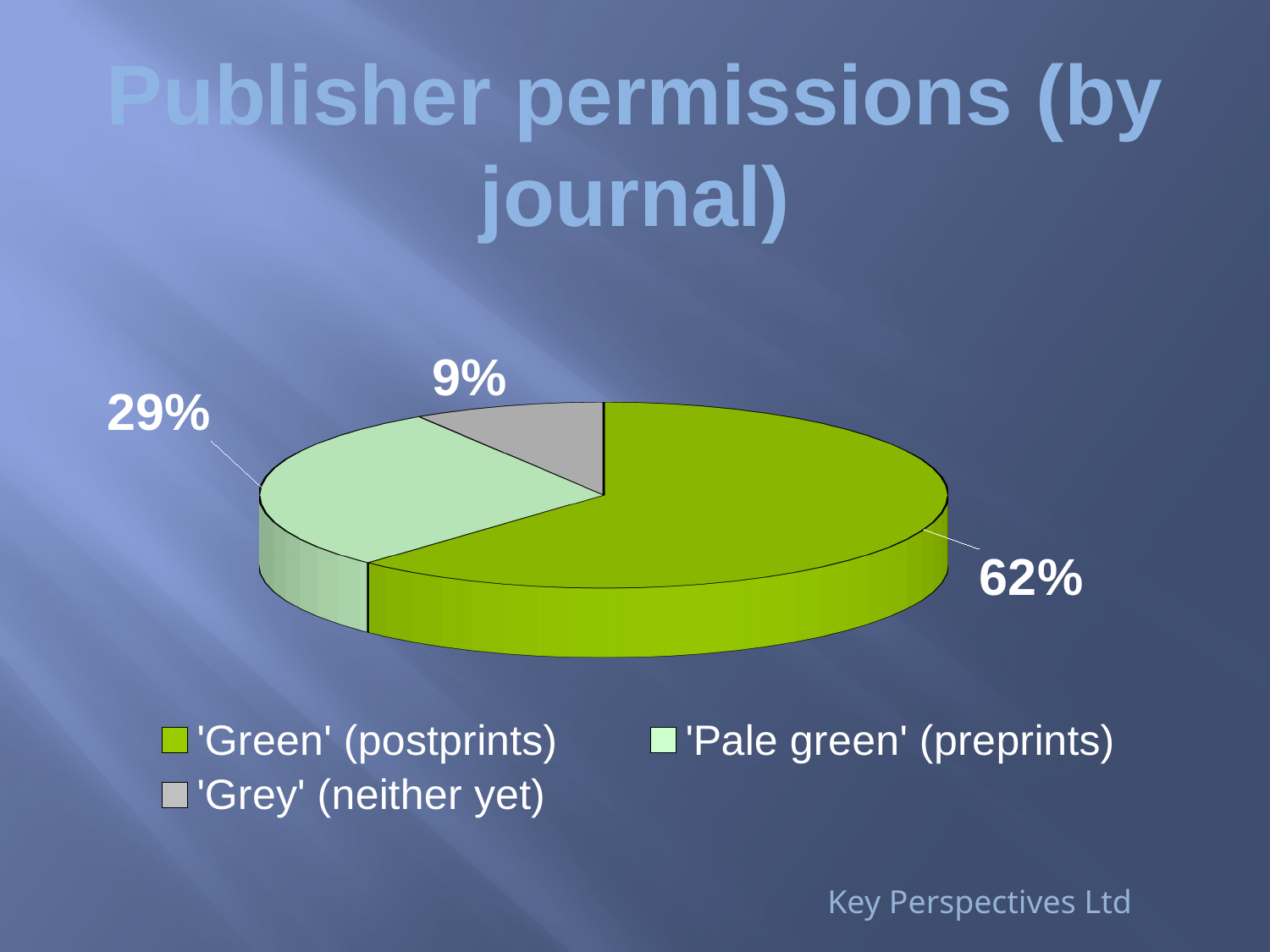
What is the difference in percentage points between 'Pale green' (preprints) and 'Grey' (neither yet)? 20 What share of the pie is 'Pale green' (preprints)? 29% What share of the pie is 'Green' (postprints)? 62% What share of the pie is 'Grey' (neither yet)? 9% What is the title of the chart? Publisher permissions (by journal) What is the difference in percentage points between 'Green' (postprints) and 'Pale green' (preprints)? 33 What type of chart is shown on the slide? pie chart How many slices does the pie chart have? 3 Which category has the largest share of the pie? 'Green' (postprints) Which category has the smallest share of the pie? 'Grey' (neither yet) What colour is the slice for 'Grey' (neither yet)? grey Which is larger, the share for 'Pale green' (preprints) or the share for 'Grey' (neither yet)? 'Pale green' (preprints)